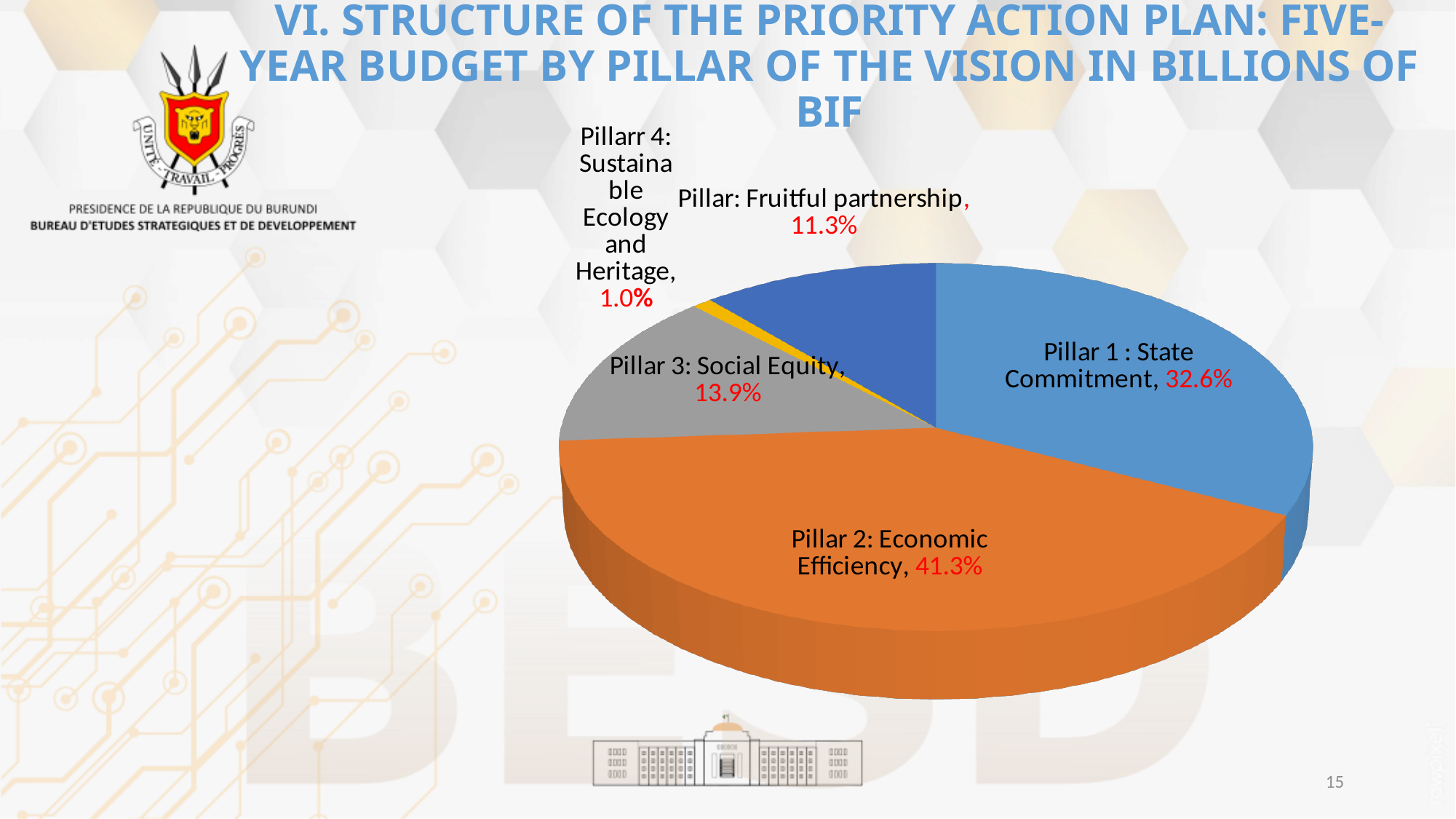
What share of the five-year budget goes to Pillar 1: State Commitment? 32.6% What share of the five-year budget goes to Pillar 2: Economic Efficiency? 41.3% What share of the five-year budget goes to Pillar 4: Sustainable Ecology and Heritage? 1.0% What kind of chart is shown on the slide? Pie chart How many pillars (slices) are shown in the pie chart? 5 What share of the five-year budget goes to Pillar 3: Social Equity? 13.9% Which pillar receives the largest share of the five-year budget? Pillar 2: Economic Efficiency What colour is the slice for Pillar 2: Economic Efficiency? Orange Which pillar receives the smallest share of the five-year budget? Pillar 4: Sustainable Ecology and Heritage What share of the five-year budget goes to the Fruitful partnership pillar? 11.3% Which has the larger share, Pillar 3: Social Equity or the Fruitful partnership pillar? Pillar 3: Social Equity What is the difference in percentage points between the shares of Pillar 2: Economic Efficiency and Pillar 1: State Commitment? 8.7